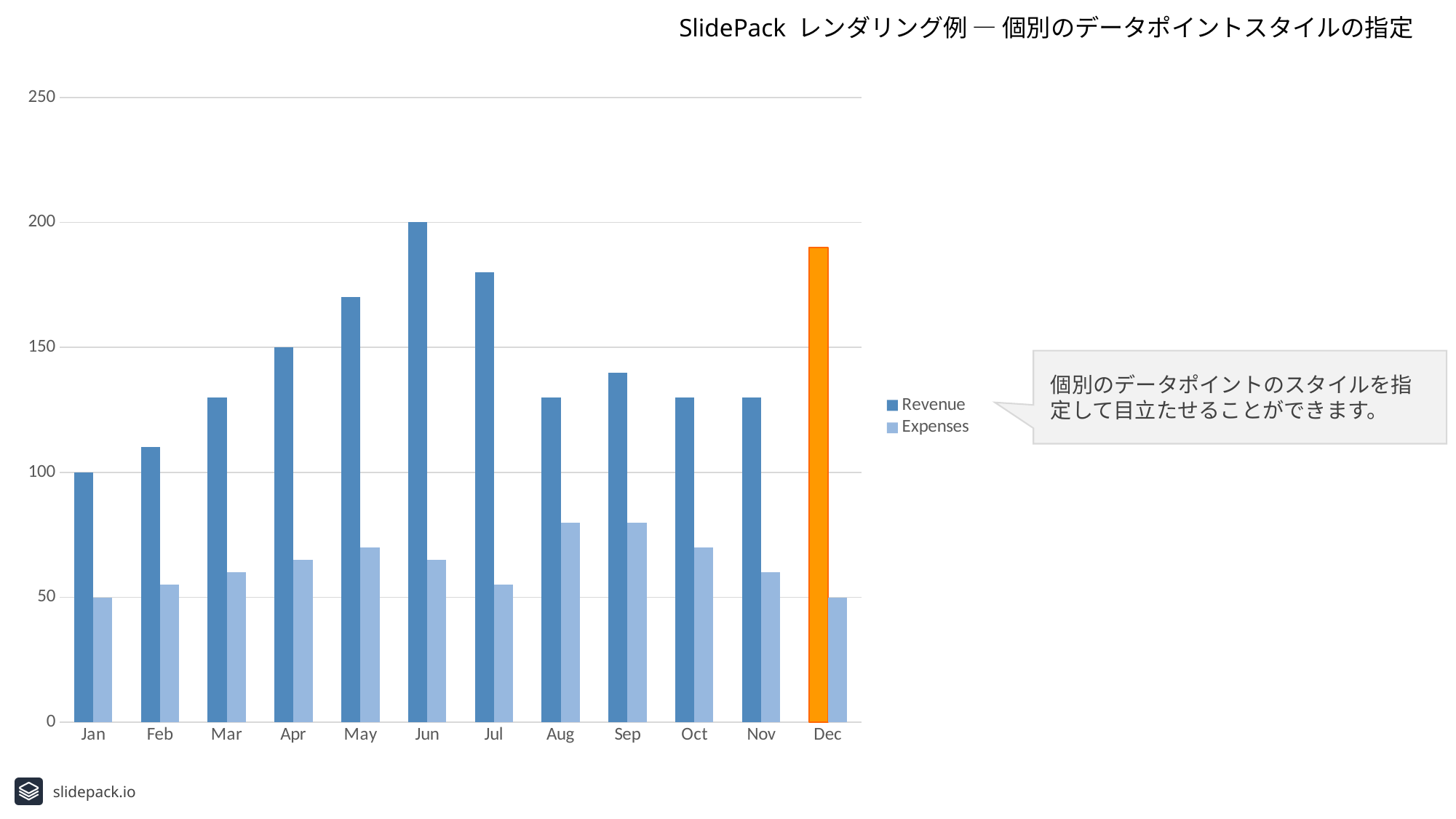
Is the Expenses value for Aug greater or less than 50? greater Which month has the highest Revenue? Jun What is the difference between the Revenue for Jun and the Revenue for Jan? 100 What colour is the Dec Revenue bar? Orange What is the Revenue value for Jun? 200 What is the Expenses value for Jan? 50 How many months are shown on the x axis? 12 Which is larger in Jan, Revenue or Expenses? Revenue What is the Revenue value for Jan? 100 Which month has the lowest Revenue? Jan How many series does the legend list? 2 Is the Revenue value for Dec greater or less than 150? greater